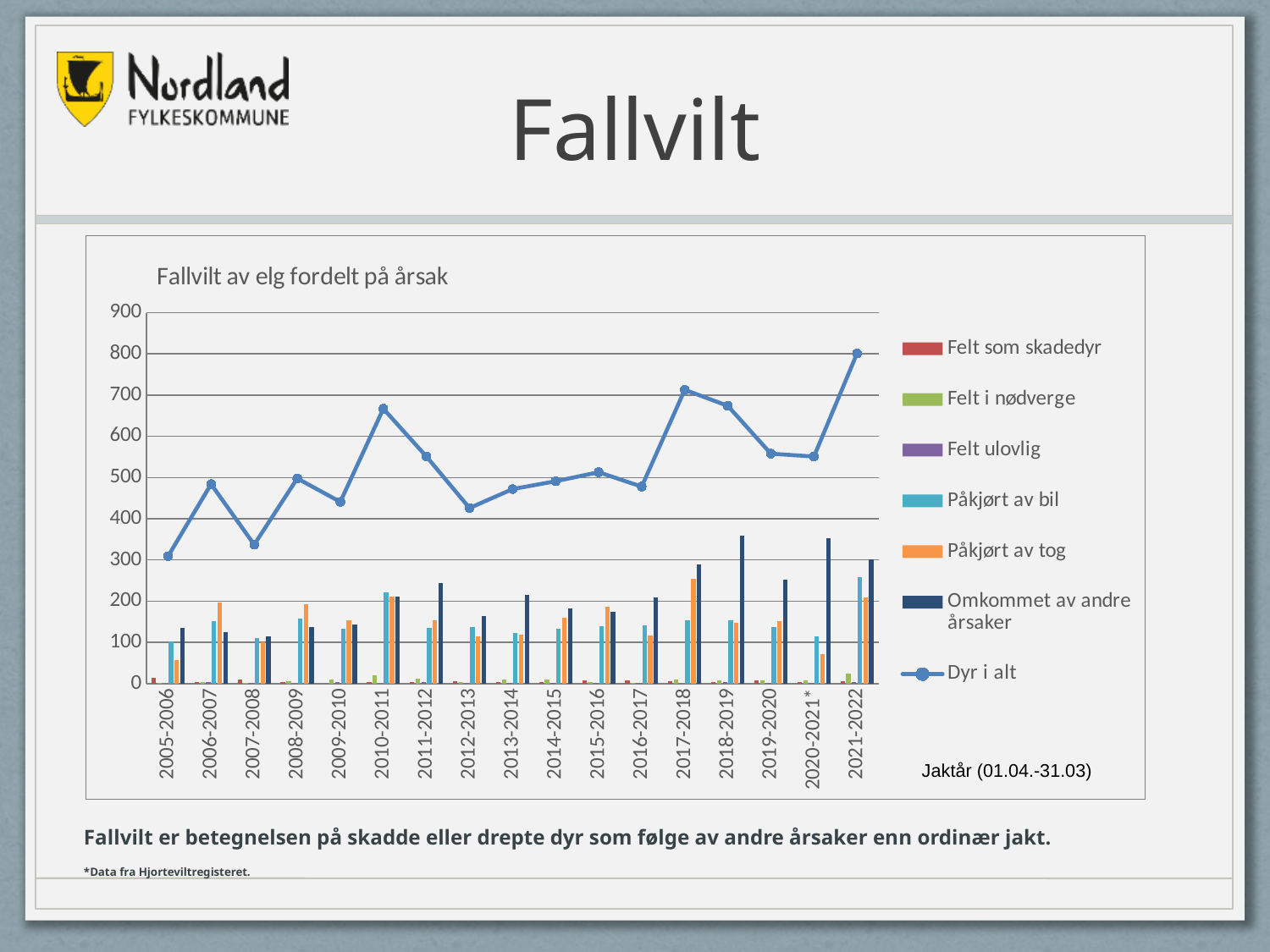
What is the title of the chart? Fallvilt av elg fordelt på årsak Is the 'Dyr i alt' value for 2005-2006 greater or less than 400? less Which is larger, the 'Dyr i alt' value for 2010-2011 or for 2011-2012? 2010-2011 Is the 'Dyr i alt' value for 2012-2013 greater or less than 500? less Overall, does the 'Dyr i alt' line rise or fall from 2005-2006 to 2021-2022? rise In which hunting year is the 'Påkjørt av tog' bar the tallest? 2017-2018 What kind of chart is shown on the slide? A combined bar and line chart In which hunting year is the 'Dyr i alt' line at its highest? 2021-2022 Is the 'Dyr i alt' value for 2010-2011 greater or less than 600? greater How many series does the chart's legend list? 7 How many hunting years (categories) are shown on the x axis? 17